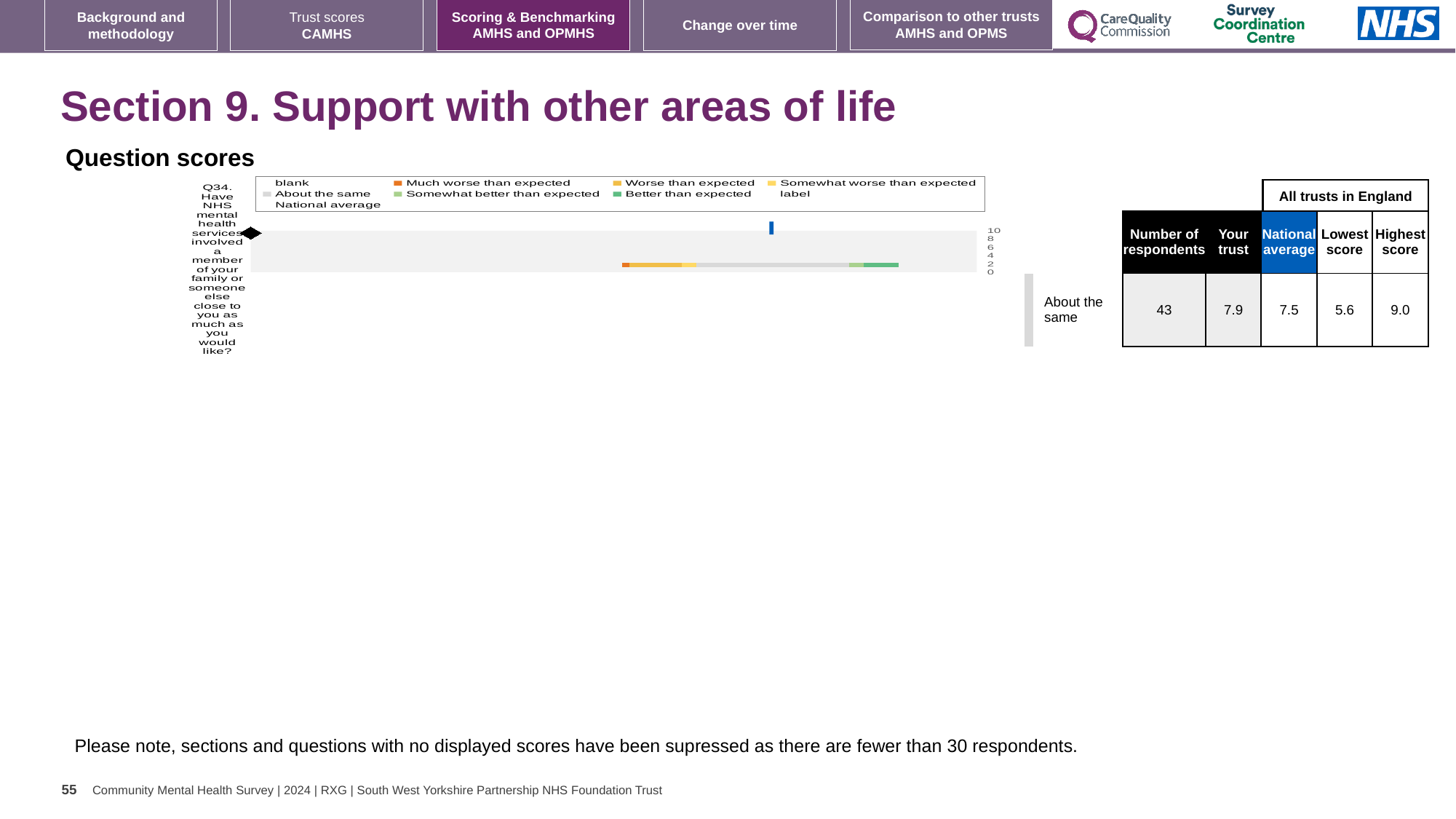
What is the maximum value shown on the score axis of the chart? 10 What is the difference between the highest and lowest trust scores for Q34? 3.4 By how much does the trust's score for Q34 exceed the national average? 0.4 How many respondents answered Q34? 43 What is the highest score among all trusts in England for Q34? 9.0 How many questions are plotted in the Question scores chart? 1 What kind of chart is used to show the Q34 question score? bar chart What is the national average score shown for Q34? 7.5 Which is higher for Q34, the trust's score or the national average? Your trust What is the 'Your trust' score shown for Q34? 7.9 What is the lowest score among all trusts in England for Q34? 5.6 Which benchmark category is the trust's Q34 score placed in? About the same